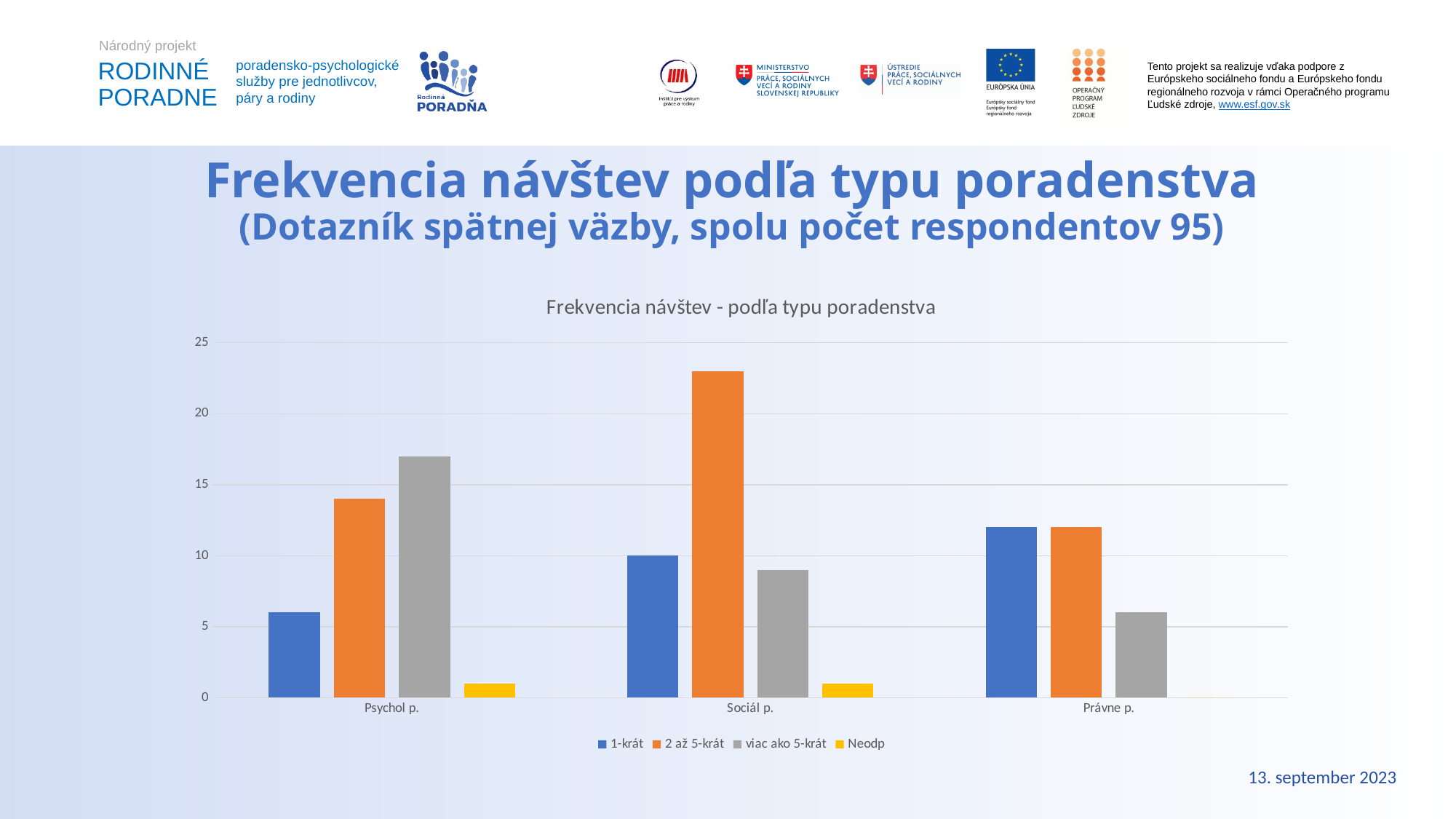
Is the value for '2 až 5-krát' in Sociál p. greater or less than 20? greater In Právne p., which is larger: '1-krát' or 'viac ako 5-krát'? 1-krát What is the title of the chart? Frekvencia návštev - podľa typu poradenstva Which category has the highest value for the '2 až 5-krát' series? Sociál p. Which category has the lowest value for the 'viac ako 5-krát' series? Právne p. What colour represents the 'Neodp' series in the legend? yellow How many series does the legend list? 4 Is the value for 'viac ako 5-krát' in Psychol p. greater or less than 15? greater How many categories are shown on the x axis? 3 In Psychol p., which is larger: '1-krát' or 'viac ako 5-krát'? viac ako 5-krát What kind of chart is shown on the slide? bar chart Is the value for '1-krát' in Psychol p. greater or less than 10? less